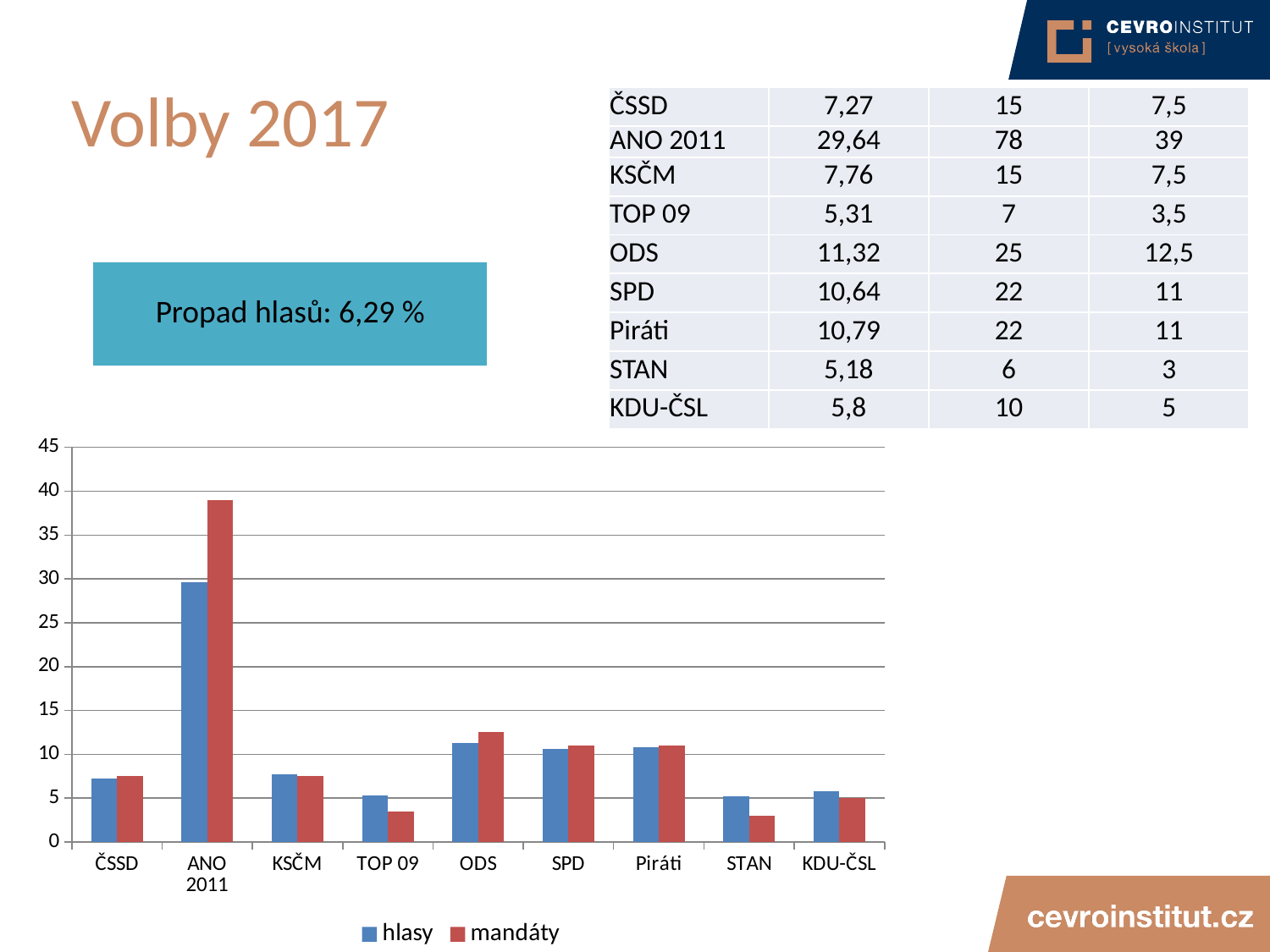
For STAN, which is larger in the chart: hlasy or mandáty? hlasy Which party has the lowest value for mandáty in the chart? STAN Is the mandáty value for ANO 2011 greater or less than 35? greater For ANO 2011, which is larger in the chart: hlasy or mandáty? mandáty Is the mandáty value for TOP 09 greater or less than 5? less What kind of chart is shown on the slide? bar chart How many parties are shown on the x axis of the chart? 9 What are the two legend entries of the chart? hlasy, mandáty Which party has the highest value for hlasy in the chart? ANO 2011 What colour are the mandáty bars in the chart? red Is the hlasy value for ODS greater or less than 10? greater How many series does the chart legend list? 2